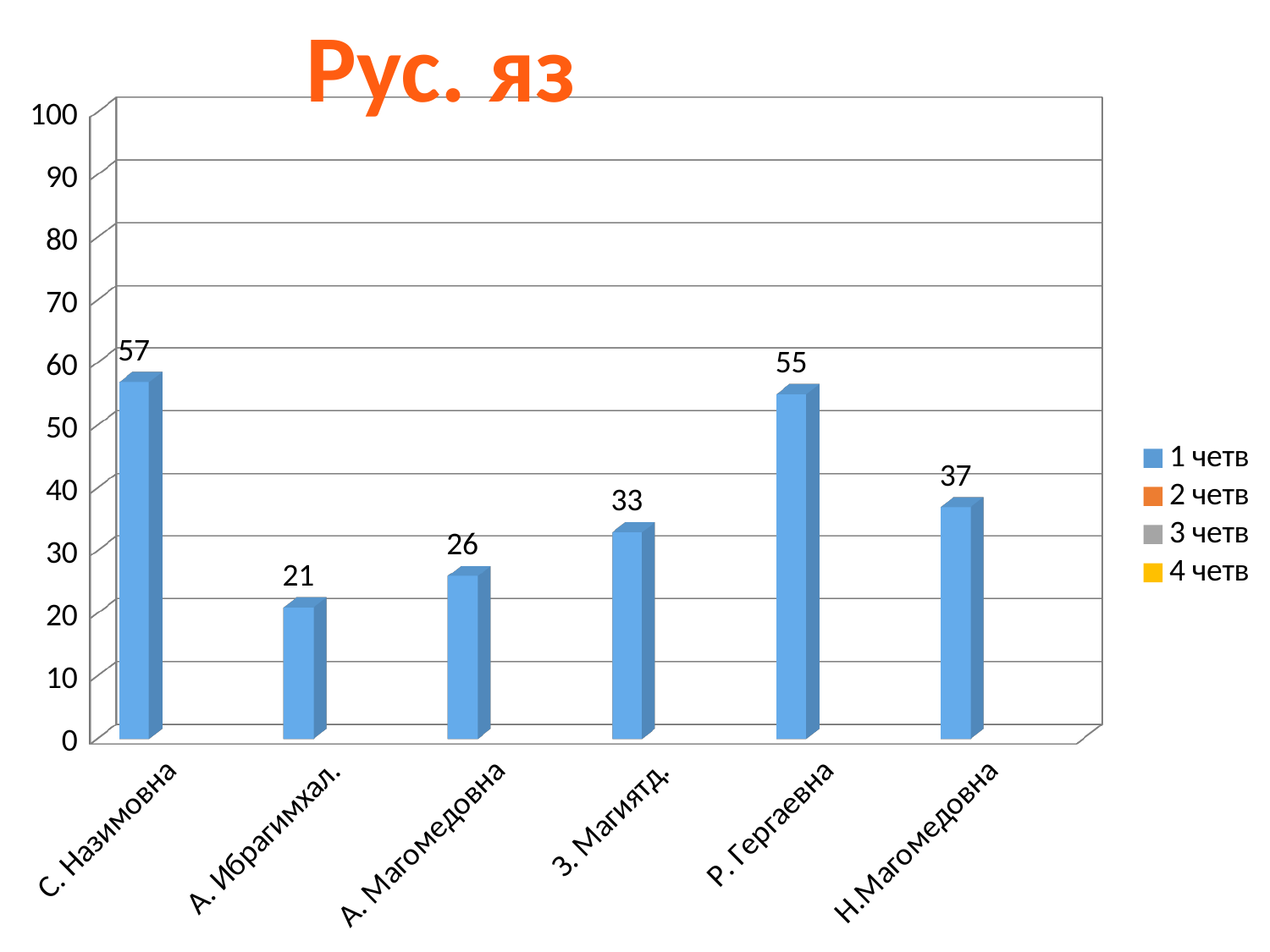
What is the value for Р. Гергаевна? 55 Is the value for Р. Гергаевна greater or less than 50? greater What is the value for А. Ибрагимхал.? 21 What is the value for Н.Магомедовна? 37 What kind of chart is shown on the slide? bar chart How many categories are shown on the x axis? 6 What is the difference between the values for С. Назимовна and А. Ибрагимхал.? 36 What is the value for С. Назимовна? 57 Which is larger, the value for З. Магиятд. or the value for А. Магомедовна? З. Магиятд. How many series does the legend list? 4 Which category has the highest value? С. Назимовна Which category has the lowest value? А. Ибрагимхал.